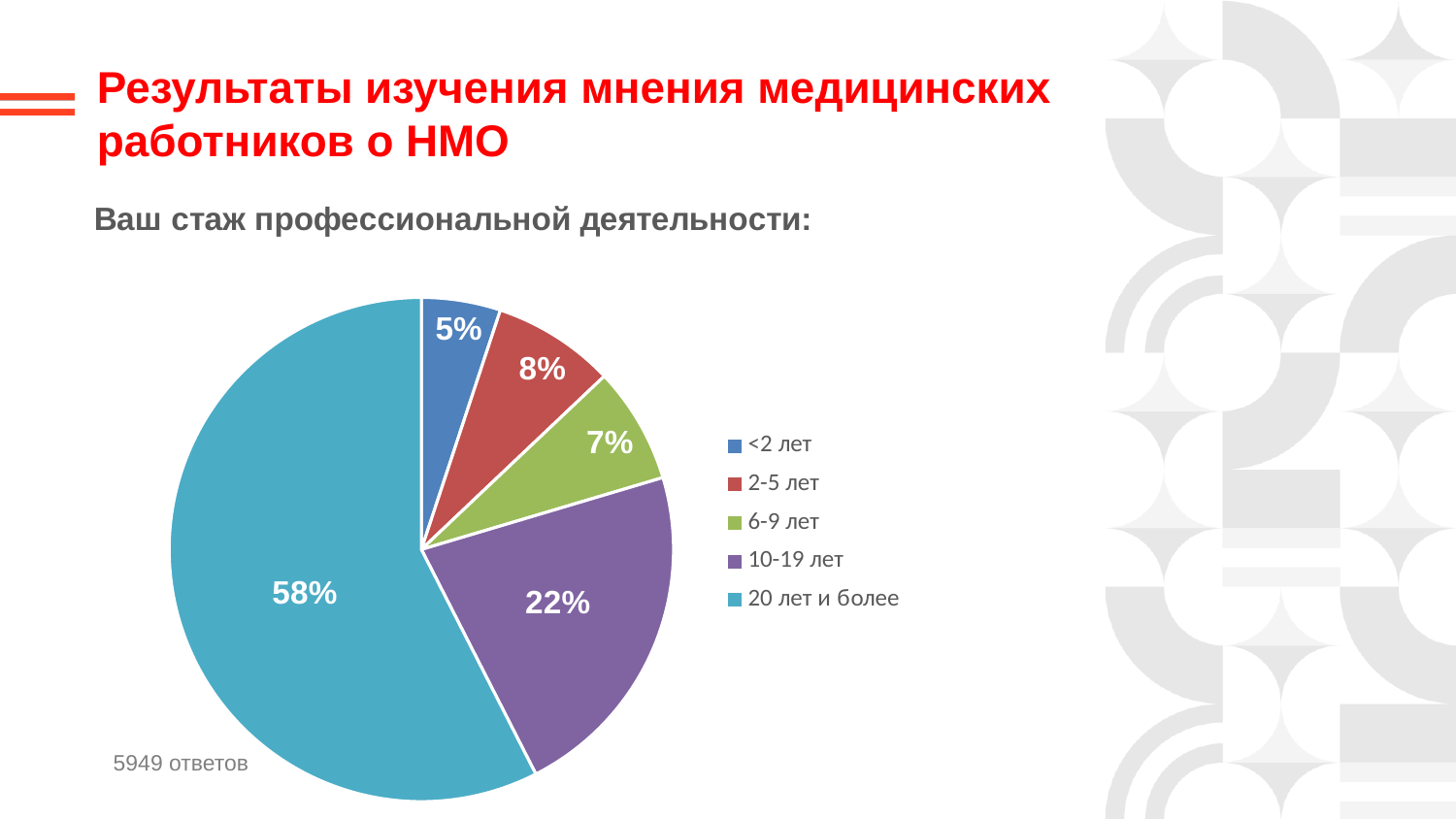
What share of respondents have professional experience of 10-19 лет? 22% How many responses does the chart note say it is based on? 5949 ответов What is the difference in percentage points between the 20 лет и более slice and the 10-19 лет slice? 36 What kind of chart is shown on the slide? pie chart Which experience category has the smallest share of the pie? <2 лет Which slice is larger: 2-5 лет or 6-9 лет? 2-5 лет Which experience category has the largest share of the pie? 20 лет и более What share of respondents have professional experience of 6-9 лет? 7% How many categories does the pie chart have? 5 What share of respondents have professional experience of 20 лет и более? 58% What share of respondents have professional experience of 2-5 лет? 8% What share of respondents have professional experience of <2 лет? 5%